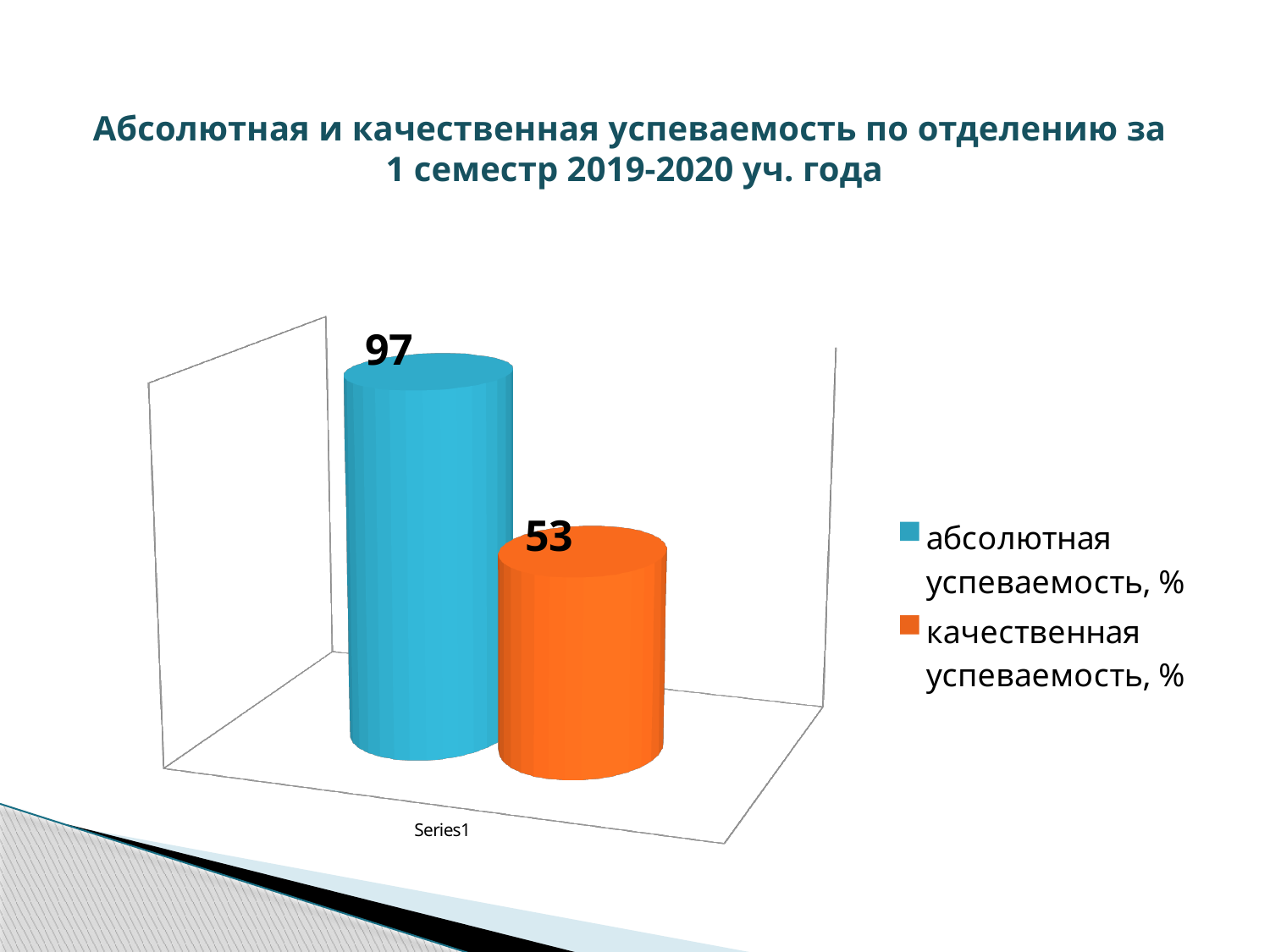
What is the title of the chart? Абсолютная и качественная успеваемость по отделению за 1 семестр 2019-2020 уч. года What is the difference between абсолютная успеваемость, % and качественная успеваемость, %? 44 How many series does the legend list? 2 Which series has the highest value? абсолютная успеваемость, % What colour is the bar for качественная успеваемость, %? orange Which series has the lowest value? качественная успеваемость, % What kind of chart is shown on the slide? bar chart What is the value for абсолютная успеваемость, %? 97 How many bars are plotted on the chart? 2 Which is larger, абсолютная успеваемость, % or качественная успеваемость, %? абсолютная успеваемость, % What is the value for качественная успеваемость, %? 53 What is the category label shown on the x axis? Series1